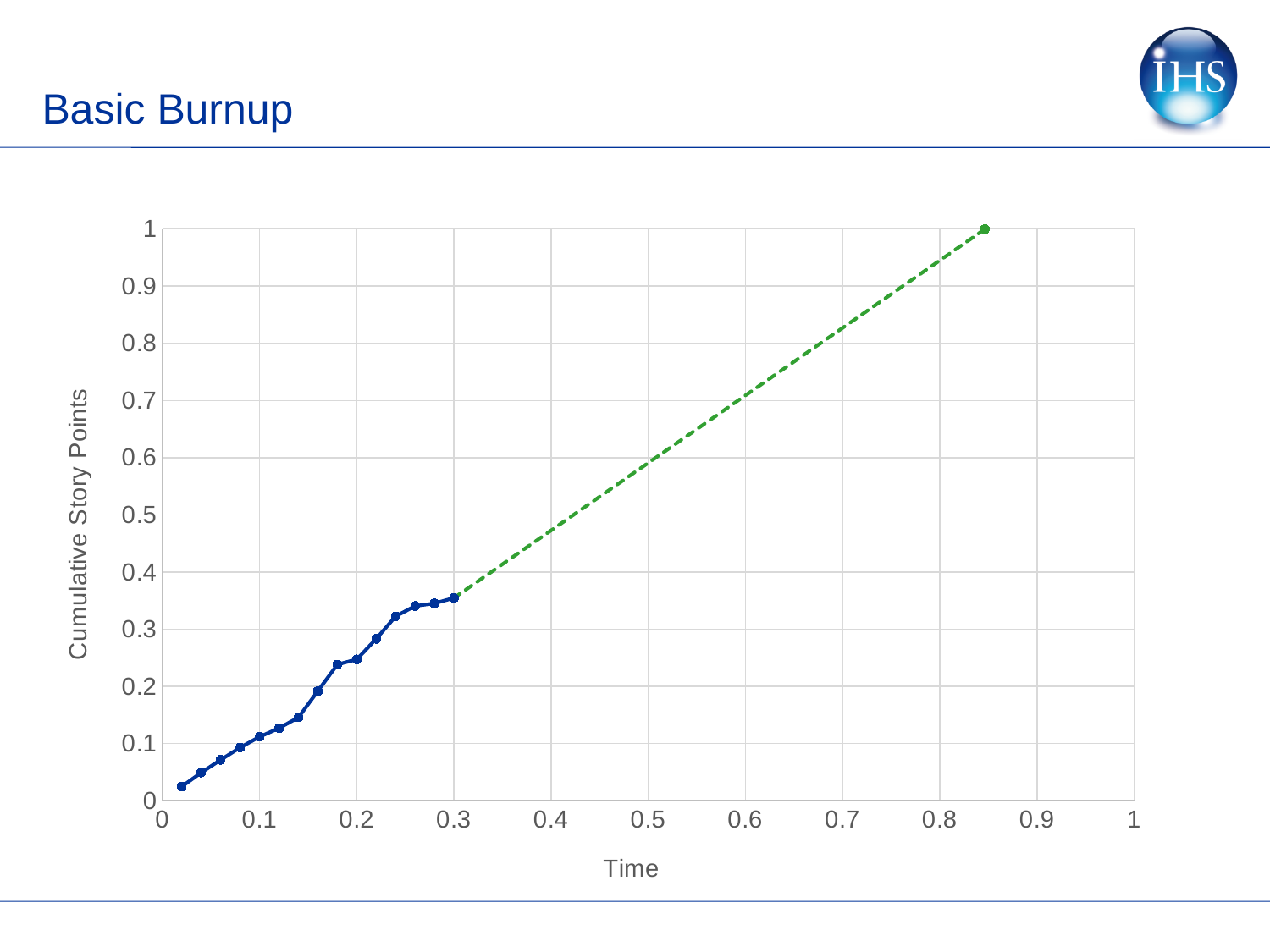
What is the title of the x axis? Time Is the value of the blue line at Time 0.2 greater or less than 0.2? greater Is the value of the blue line at Time 0.3 greater or less than 0.4? less What is the title of the y axis? Cumulative Story Points Do the values of the blue line rise or fall as time increases? rise At which Time value does the solid blue line reach its highest point? 0.3 Is the Time value of the end point of the green dashed line greater or less than 0.8? greater What kind of chart is shown on the slide? line chart What is the Cumulative Story Points value at the end point of the green dashed line? 1 How many data points are marked on the solid blue line? 15